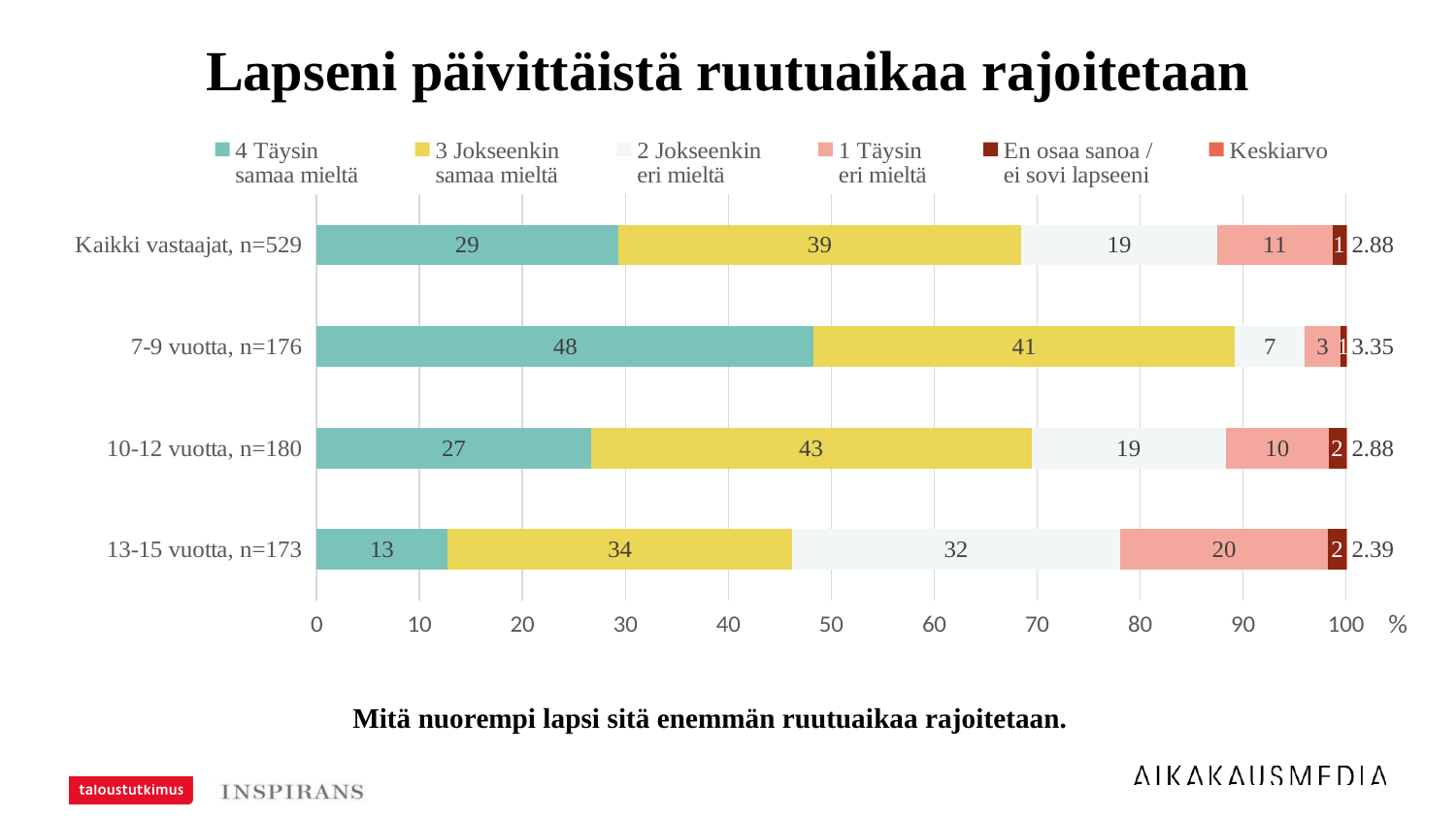
Which group has the lowest Keskiarvo value? 13-15 vuotta, n=173 How many categories (respondent groups) are shown on the chart? 4 What is the value of '1 Täysin eri mieltä' for 'Kaikki vastaajat, n=529'? 11 What type of chart is shown on the slide? stacked bar chart What is the value of '4 Täysin samaa mieltä' for '7-9 vuotta, n=176'? 48 What is the total of the stacked bar for '7-9 vuotta, n=176' (excluding Keskiarvo)? 100 Which group has the highest '4 Täysin samaa mieltä' value? 7-9 vuotta, n=176 How many series does the legend list? 6 What is the difference between the '3 Jokseenkin samaa mieltä' values for '10-12 vuotta, n=180' and '13-15 vuotta, n=173'? 9 Which is larger: the '2 Jokseenkin eri mieltä' value for '13-15 vuotta, n=173' or for '10-12 vuotta, n=180'? 13-15 vuotta, n=173 What is the title of the chart? Lapseni päivittäistä ruutuaikaa rajoitetaan What is the Keskiarvo value for '13-15 vuotta, n=173'? 2.39